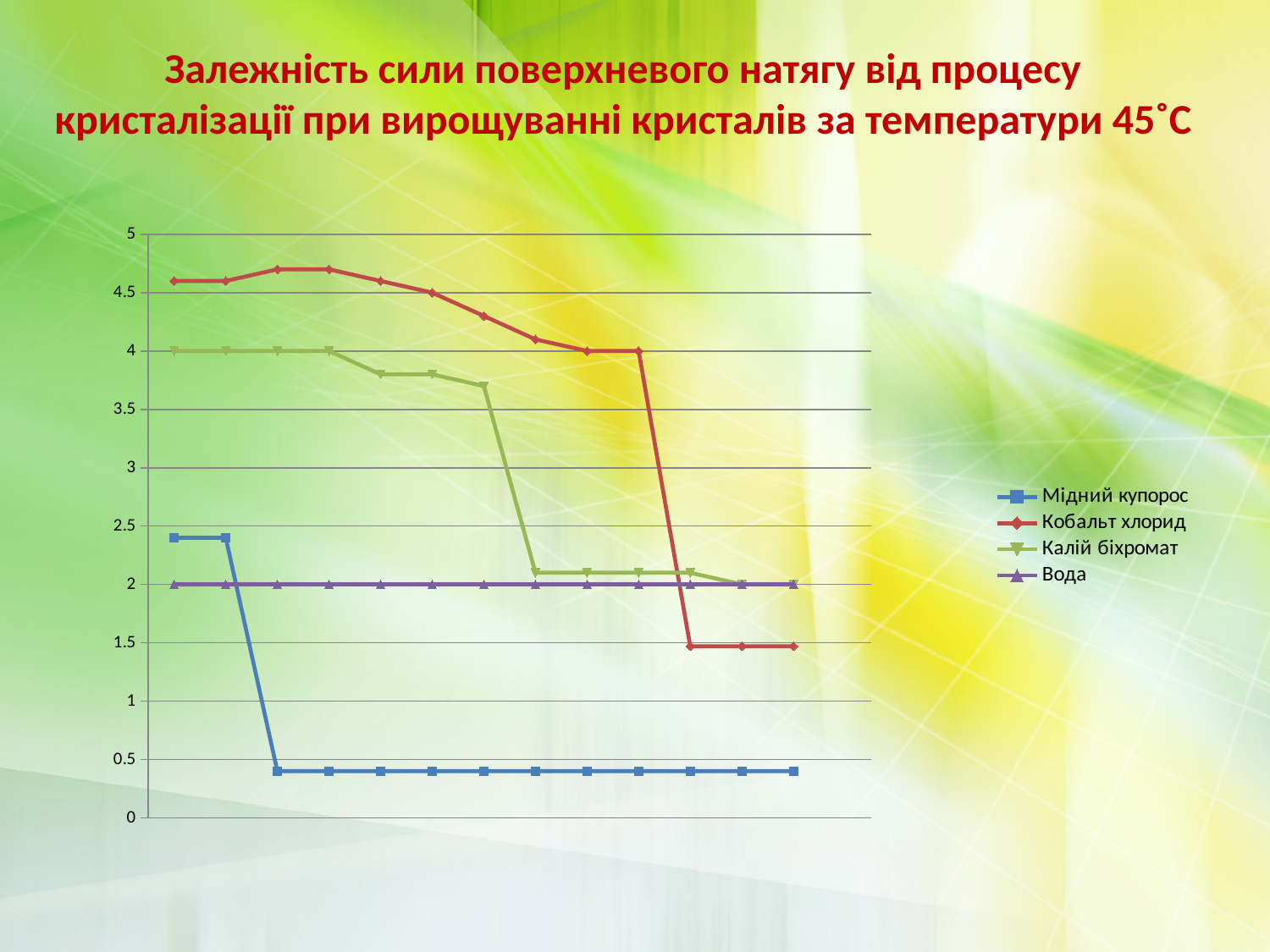
What colour is the Вода series line? purple What is the value of Калій біхромат at the first point? 4 Is the last value for Кобальт хлорид greater or less than 2? less What kind of chart is shown on the slide? line chart Is the first value for Мідний купорос greater or less than 2? greater How many data points does the Вода series have? 13 How many series does the legend list? 4 Which series has the highest value at the first point? Кобальт хлорид At the last point, which is larger: Вода or Мідний купорос? Вода Which series has the lowest value at the last point? Мідний купорос What is the constant value of the Вода series? 2 Do the values for Кобальт хлорид rise or fall overall along the x axis? fall